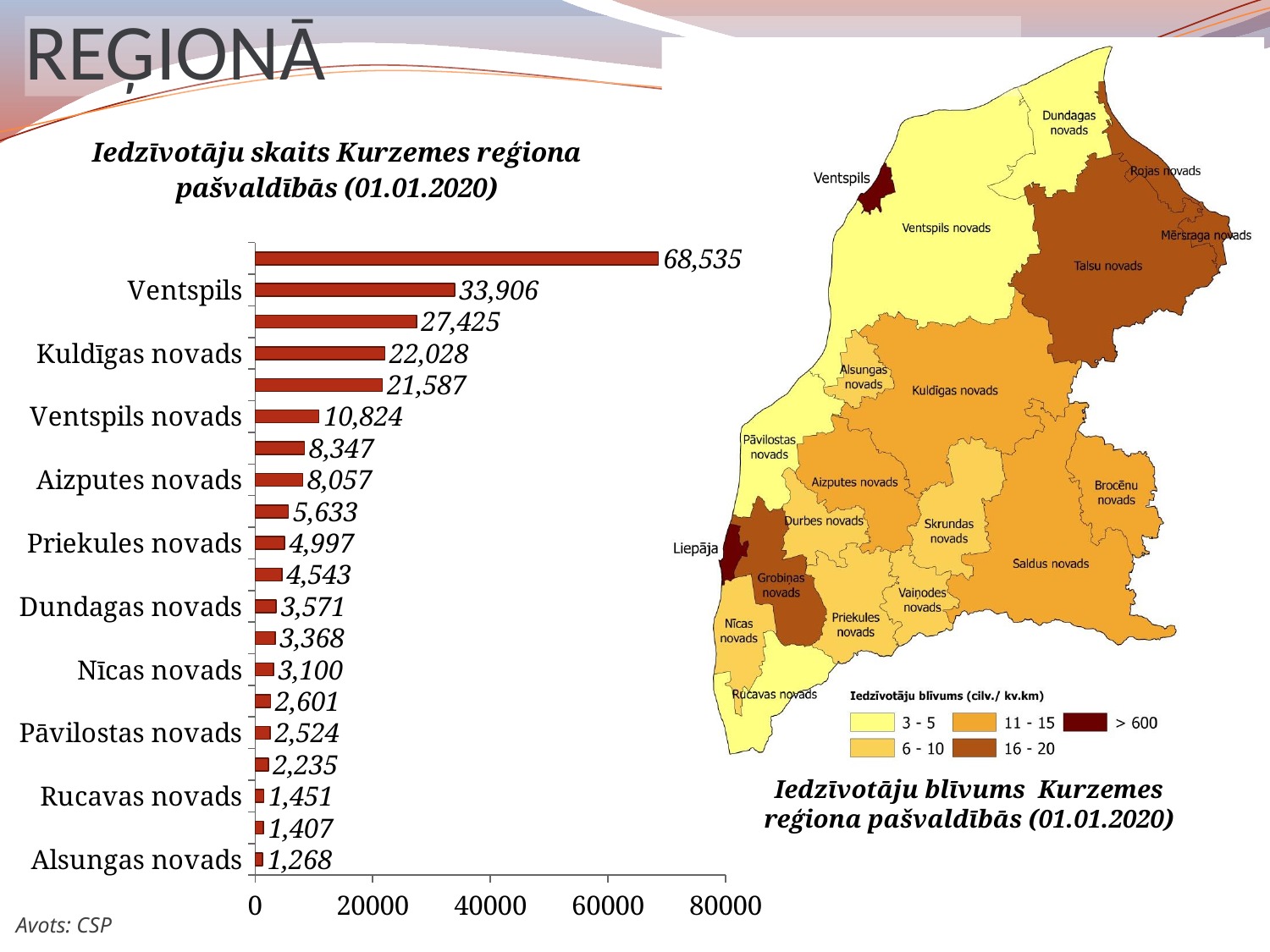
In the bar chart, what is the value for Priekules novads? 4,997 In the bar chart, which labelled category has the lowest value? Alsungas novads What is the title of the bar chart on the left? Iedzīvotāju skaits Kurzemes reģiona pašvaldībās (01.01.2020) In the bar chart, what is the difference between the values for Ventspils and Kuldīgas novads? 11,878 In the bar chart, what is the value for Kuldīgas novads? 22,028 In the bar chart, what is the value for Alsungas novads? 1,268 How many bars are plotted in the bar chart? 20 In the bar chart, what is the value for Ventspils? 33,906 What type of chart is shown on the left of the slide? bar chart In the bar chart, what is the largest value shown on any bar? 68,535 In the bar chart, is the value for Kuldīgas novads greater or less than 40000? less In the bar chart, which is larger: Ventspils novads or Aizputes novads? Ventspils novads